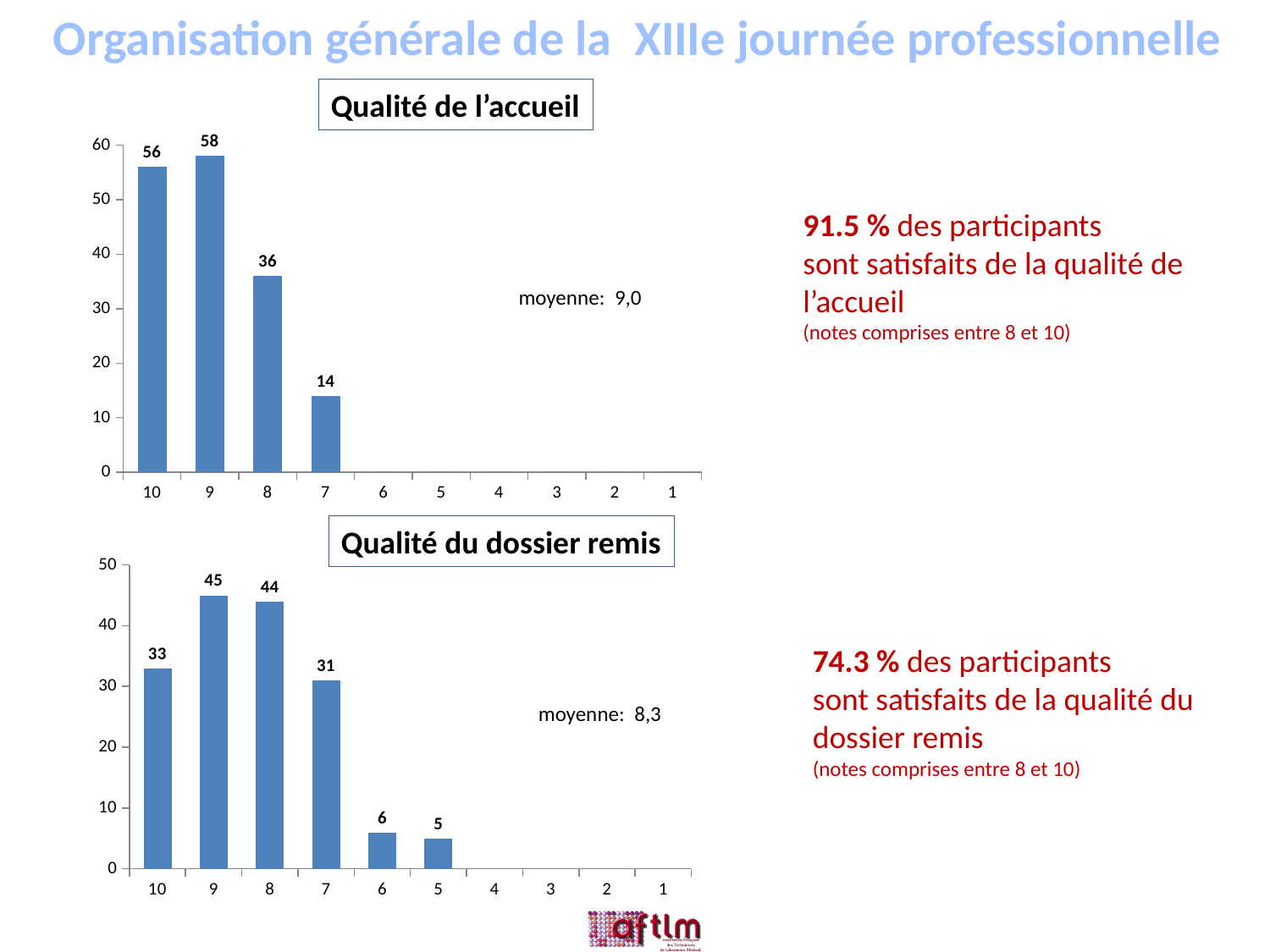
In the 'Qualité du dossier remis' chart, what is the difference between the values for scores 9 and 8? 1 In the 'Qualité du dossier remis' chart, which score has the highest value? 9 In the 'Qualité du dossier remis' chart, what is the value for the score 5? 5 In the 'Qualité de l’accueil' chart, what is the difference between the values for scores 10 and 8? 20 In the 'Qualité du dossier remis' chart, what is the value for the score 10? 33 What type of chart is the 'Qualité du dossier remis' chart? bar chart In the 'Qualité de l’accueil' chart, which score has the highest value? 9 In the 'Qualité de l’accueil' chart, is the value for score 8 greater or less than 30? greater In the 'Qualité du dossier remis' chart, which is larger, the value for score 7 or the value for score 10? score 10 In the 'Qualité de l’accueil' chart, what is the value for the score 7? 14 How many score categories are shown on the x axis of the 'Qualité de l’accueil' chart? 10 In the 'Qualité de l’accueil' chart, what is the value for the score 9? 58